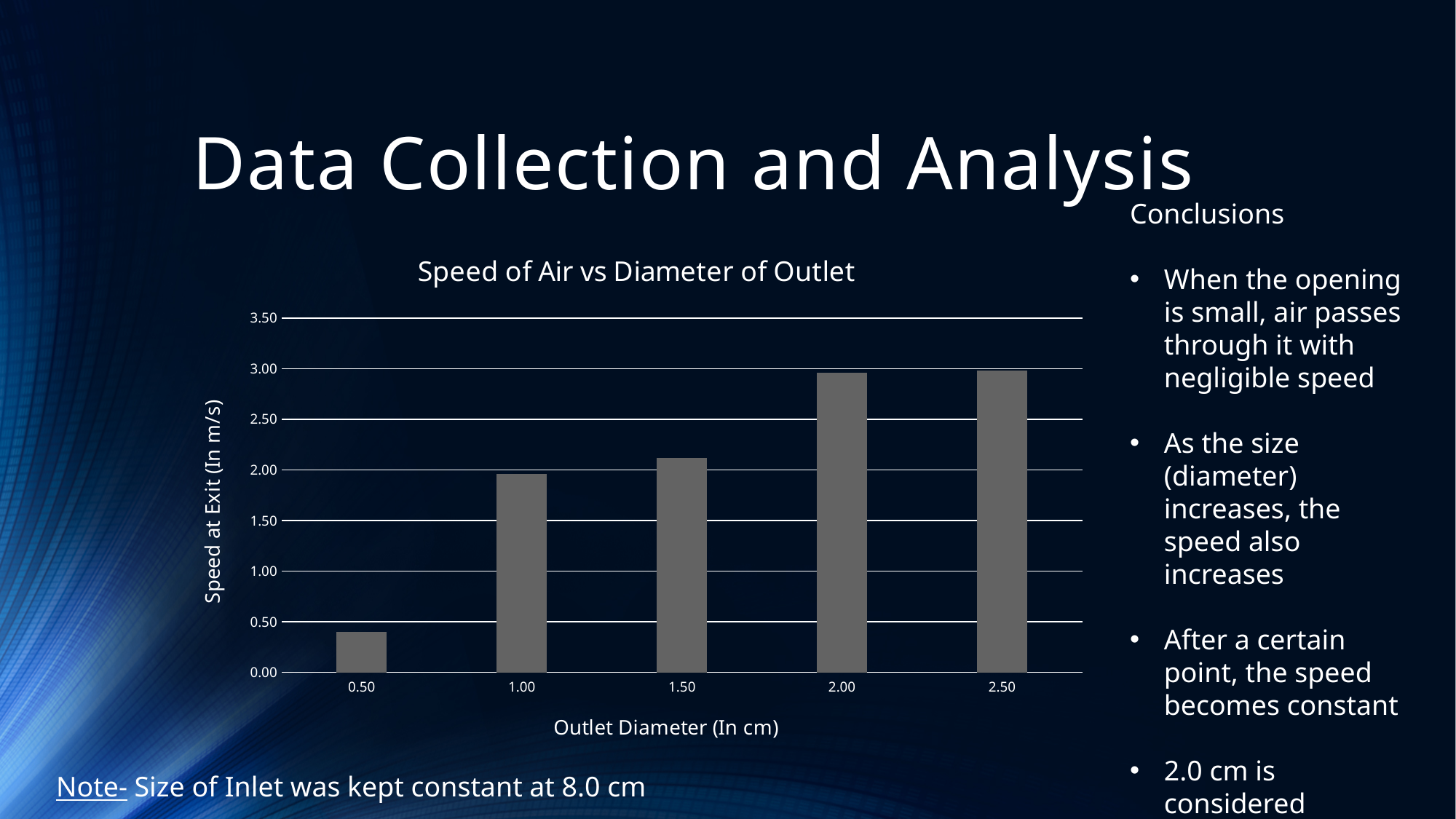
Is the speed at exit for an outlet diameter of 2.50 greater or less than 2.50? greater Which outlet diameter has the lowest speed at exit? 0.50 Do the speed values generally rise or fall as the outlet diameter increases along the x axis? Rise What kind of chart is shown on the slide? Bar chart Is the speed at exit for an outlet diameter of 1.50 greater or less than 2.00? greater What is the label of the y axis of the chart? Speed at Exit (In m/s) How many outlet diameter categories are plotted in the chart? 5 What is the title of the chart? Speed of Air vs Diameter of Outlet Is the speed at exit for an outlet diameter of 1.00 greater or less than 1.50? greater Which has a higher speed at exit: an outlet diameter of 2.00 or 1.50? 2.00